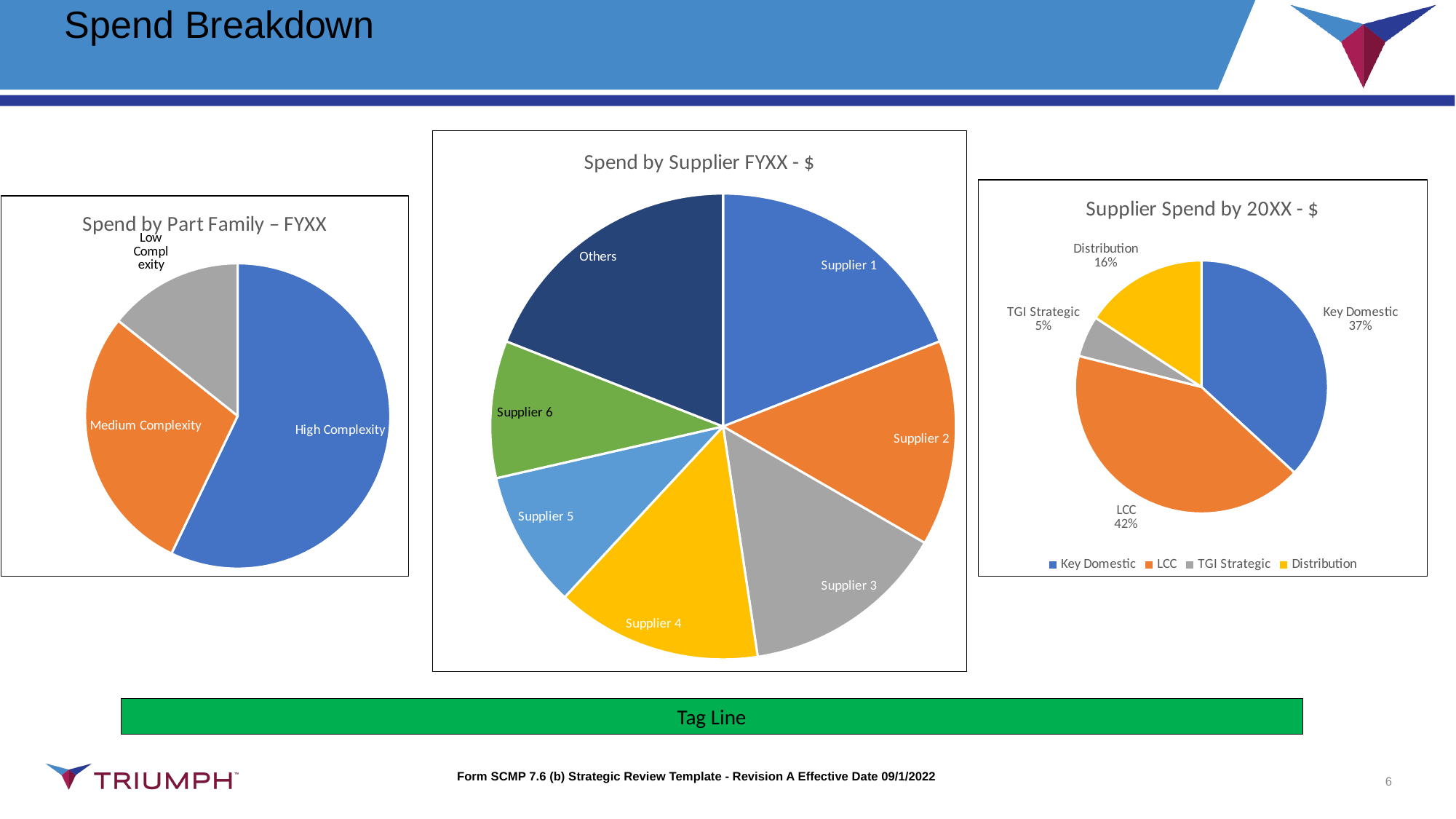
In the 'Spend by Part Family – FYXX' chart, which is larger: Medium Complexity or Low Complexity? Medium Complexity In the 'Supplier Spend by 20XX - $' chart, what share does LCC have? 42% In the 'Spend by Part Family – FYXX' chart, which part family has the largest slice? High Complexity In the 'Supplier Spend by 20XX - $' chart, what share does Key Domestic have? 37% In the 'Supplier Spend by 20XX - $' chart, which category has the smallest share? TGI Strategic In the 'Supplier Spend by 20XX - $' chart, what is the difference in percentage points between LCC and Key Domestic? 5 How many pie charts are shown on the slide? 3 In the 'Supplier Spend by 20XX - $' chart, which category has the largest share? LCC What type of chart is 'Spend by Supplier FYXX - $'? Pie chart In the 'Supplier Spend by 20XX - $' chart, what share does Distribution have? 16% In the 'Spend by Supplier FYXX - $' chart, how many slices are there? 7 In the 'Supplier Spend by 20XX - $' chart, how many categories does the legend list? 4